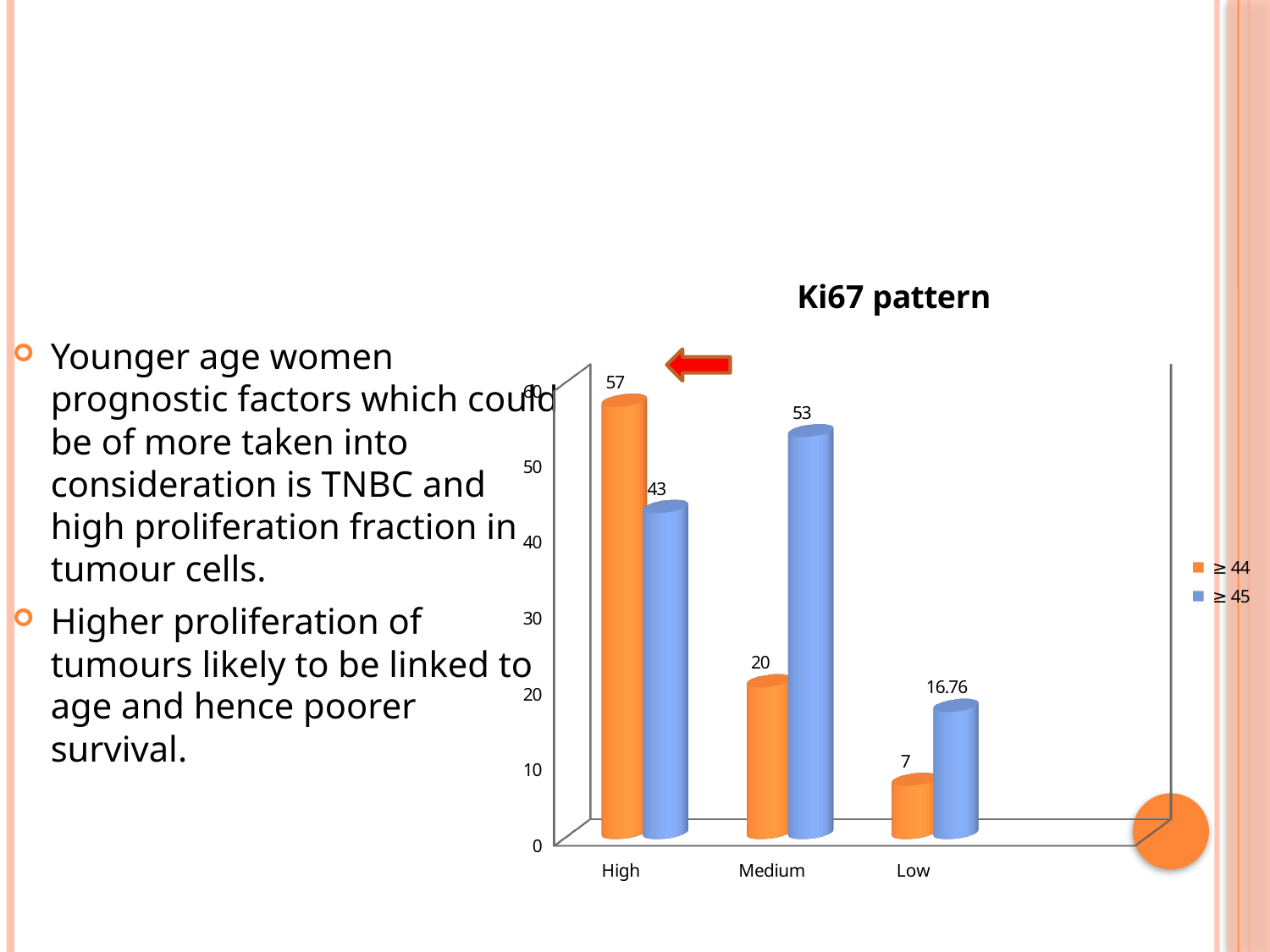
For the Medium category, which series has the larger value, ≥ 44 or ≥ 45? ≥ 45 Which category has the lowest value for the ≥ 44 series? Low Which colour represents the ≥ 44 series in the chart? orange What kind of chart is shown on the slide? bar chart Which category has the highest value for the ≥ 45 series? Medium How many categories are shown on the x axis of the chart? 3 What is the value of the ≥ 45 series for the Low category? 16.76 What is the value of the ≥ 45 series for the Medium category? 53 What is the difference between the ≥ 44 and ≥ 45 values for the High category? 14 How many series does the chart's legend list? 2 What is the title of the chart? Ki67 pattern What is the value of the ≥ 44 series for the High category? 57